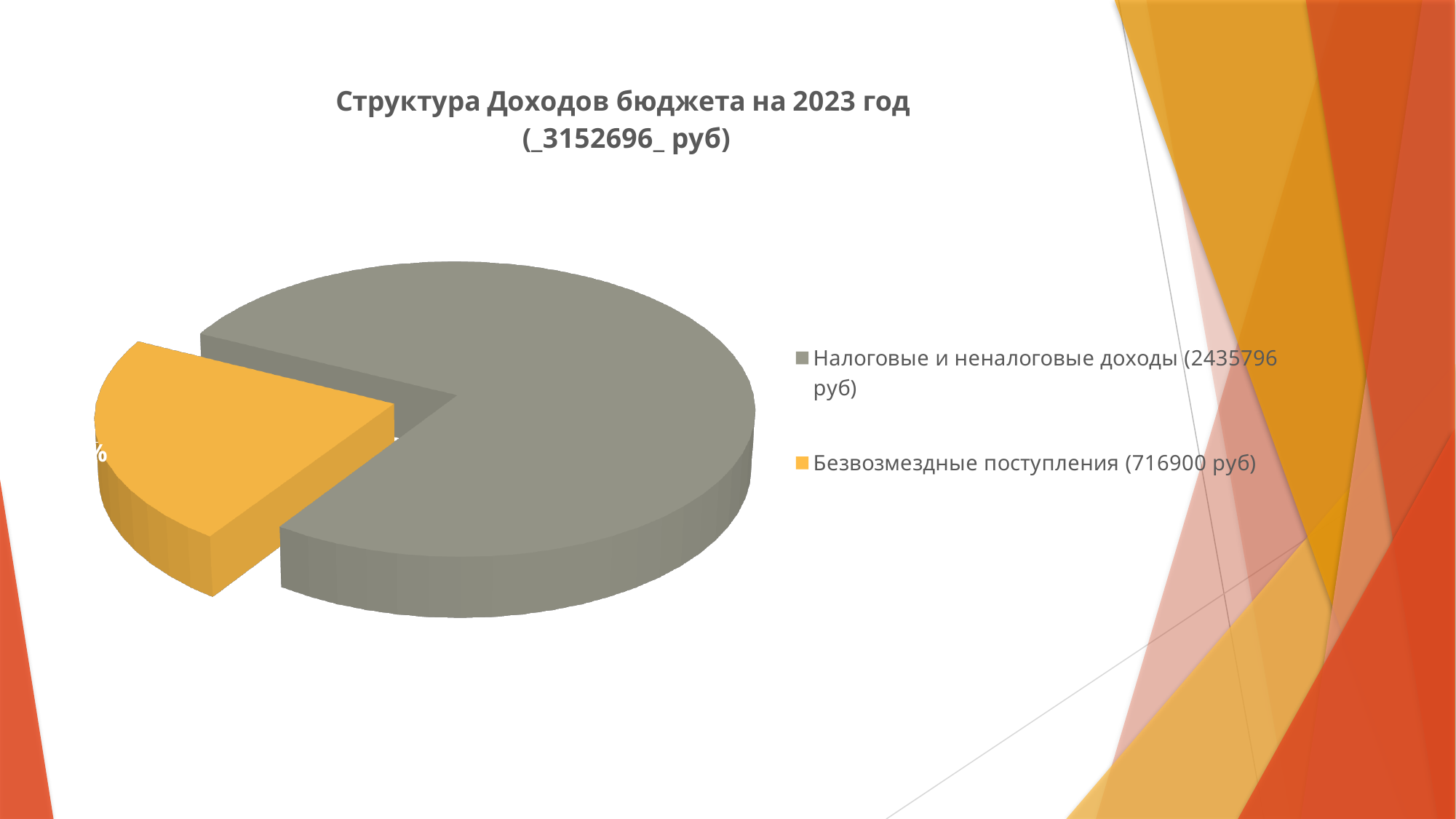
Which category has the smallest slice of the pie? Безвозмездные поступления Which is larger: Налоговые и неналоговые доходы or Безвозмездные поступления? Налоговые и неналоговые доходы How many entries does the legend list? 2 What value is given for Налоговые и неналоговые доходы? 2435796 руб What kind of chart is shown on the slide? Pie chart What total budget income is stated in the chart title? 3152696 руб How many slices does the pie chart have? 2 What is the difference between Налоговые и неналоговые доходы and Безвозмездные поступления? 1718896 руб What value is given for Безвозмездные поступления? 716900 руб Which category has the largest slice of the pie? Налоговые и неналоговые доходы What colour is the slice for Безвозмездные поступления? Orange What is the title of the chart? Структура Доходов бюджета на 2023 год (_3152696_ руб)